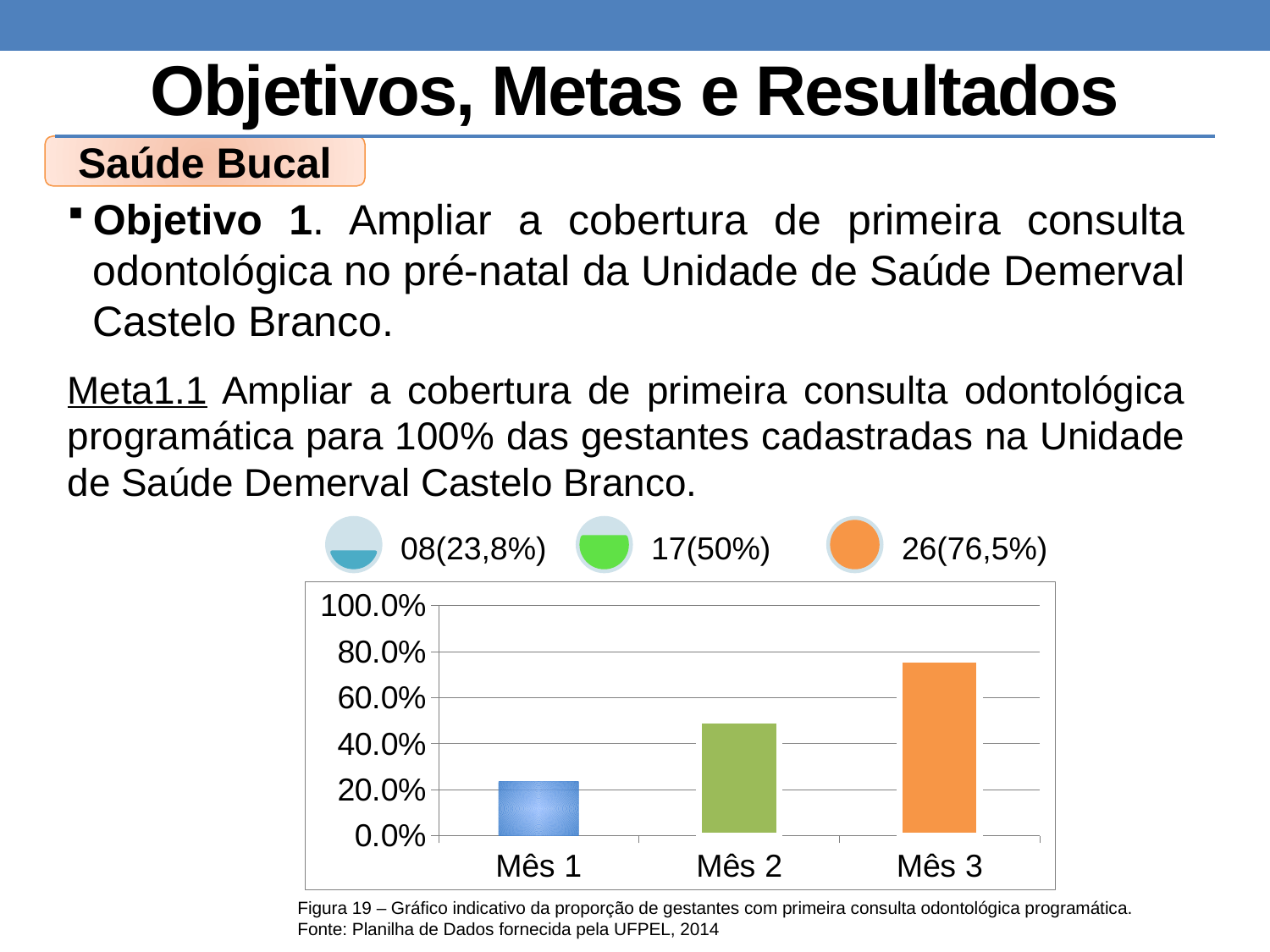
Is the value for Mês 1 greater or less than 40.0%? less According to the labels above the chart, what percentage corresponds to the blue bar (Mês 1)? 23,8% Do the bar values rise or fall from Mês 1 to Mês 3? rise According to the labels above the chart, what percentage corresponds to the orange bar (Mês 3)? 76,5% Is the value for Mês 3 greater or less than 60.0%? greater What type of chart is shown on the slide? bar chart What is the highest value shown on the y axis of the chart? 100.0% Is the value for Mês 2 greater or less than 20.0%? greater Which month has the highest bar in the chart? Mês 3 Which is larger, the value for Mês 3 or the value for Mês 1? Mês 3 Which month has the lowest bar in the chart? Mês 1 How many categories (months) are plotted on the x axis of the chart? 3